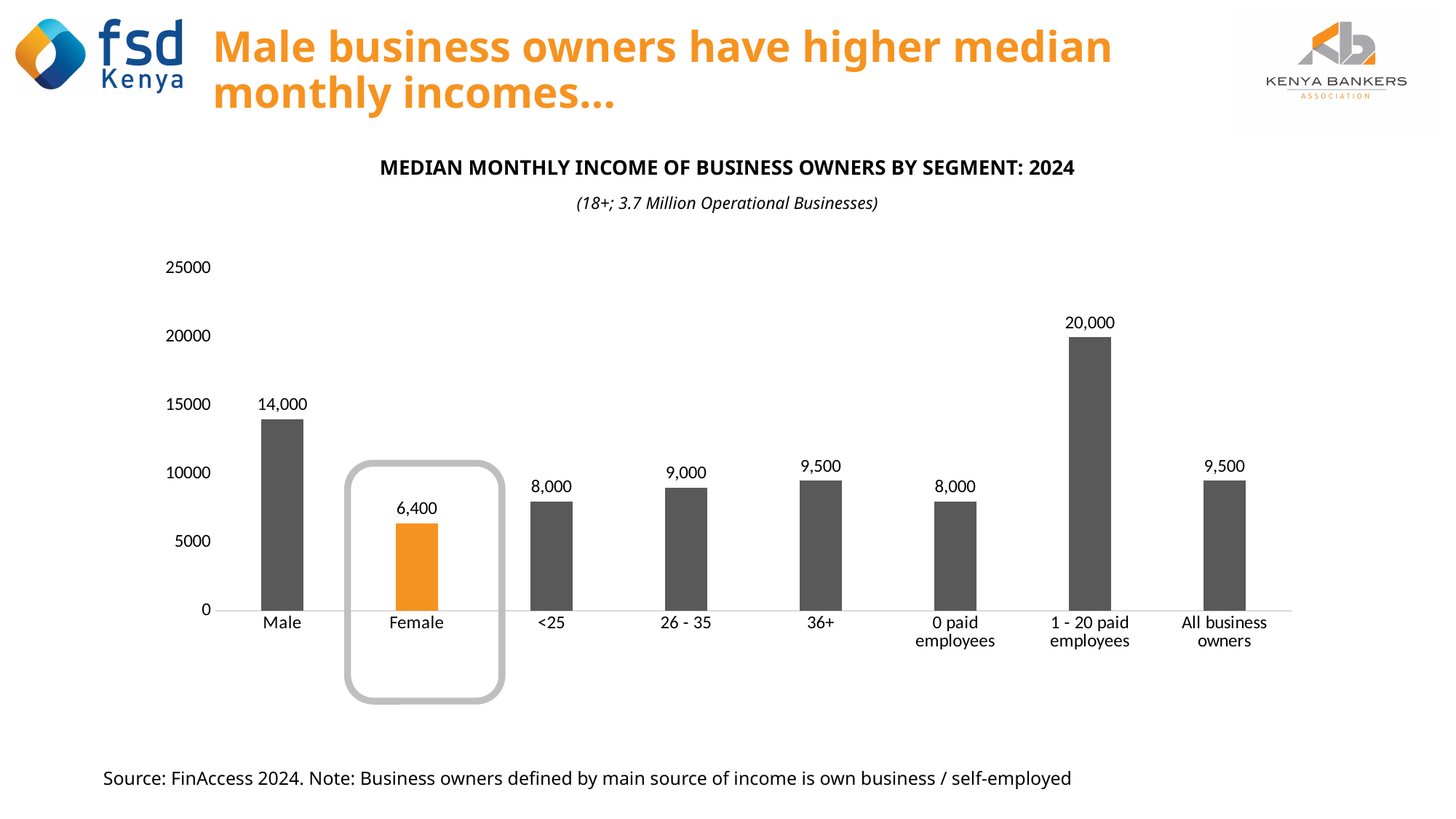
What kind of chart is shown on the slide? Bar chart What is the median monthly income for business owners with 1 - 20 paid employees? 20,000 Which segment has the highest median monthly income? 1 - 20 paid employees How many segments are shown on the chart? 8 What is the median monthly income for Male business owners? 14,000 What is the difference between the median monthly income of Male and Female business owners? 7,600 Which segment has the lowest median monthly income? Female What is the median monthly income for Female business owners? 6,400 What is the median monthly income for All business owners? 9,500 Which has a higher median monthly income: the 26 - 35 age group or the 36+ age group? 36+ Which bar on the chart is coloured orange? Female What is the difference between the median monthly income for 1 - 20 paid employees and 0 paid employees? 12,000